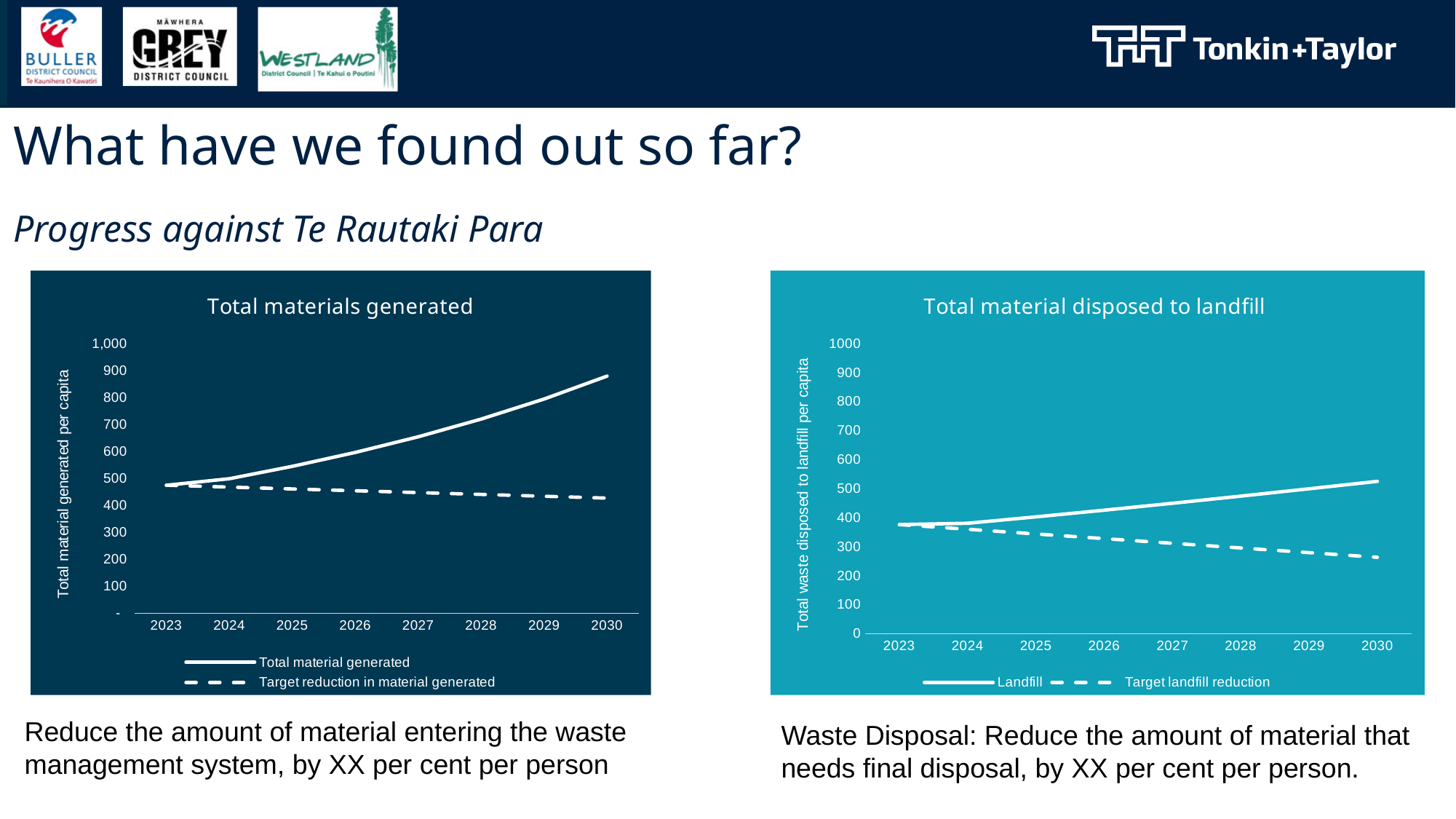
In the 'Total material disposed to landfill' chart, does the 'Target landfill reduction' line rise or fall from 2023 to 2030? fall In the 'Total materials generated' chart, is the 'Target reduction in material generated' value for 2030 greater or less than 500? less In the 'Total material disposed to landfill' chart, is the 'Landfill' value for 2030 greater or less than 400? greater In the 'Total materials generated' chart, does the 'Total material generated' line rise or fall from 2023 to 2030? rise In the 'Total materials generated' chart, is the 'Total material generated' value for 2030 greater or less than 800? greater What is the y-axis label of the 'Total material disposed to landfill' chart? Total waste disposed to landfill per capita How many series does the legend of the 'Total material disposed to landfill' chart list? 2 What kind of chart is the 'Total materials generated' chart? line chart What kind of chart is the 'Total material disposed to landfill' chart? line chart How many years are shown on the x axis of the 'Total materials generated' chart? 8 How many series does the legend of the 'Total materials generated' chart list? 2